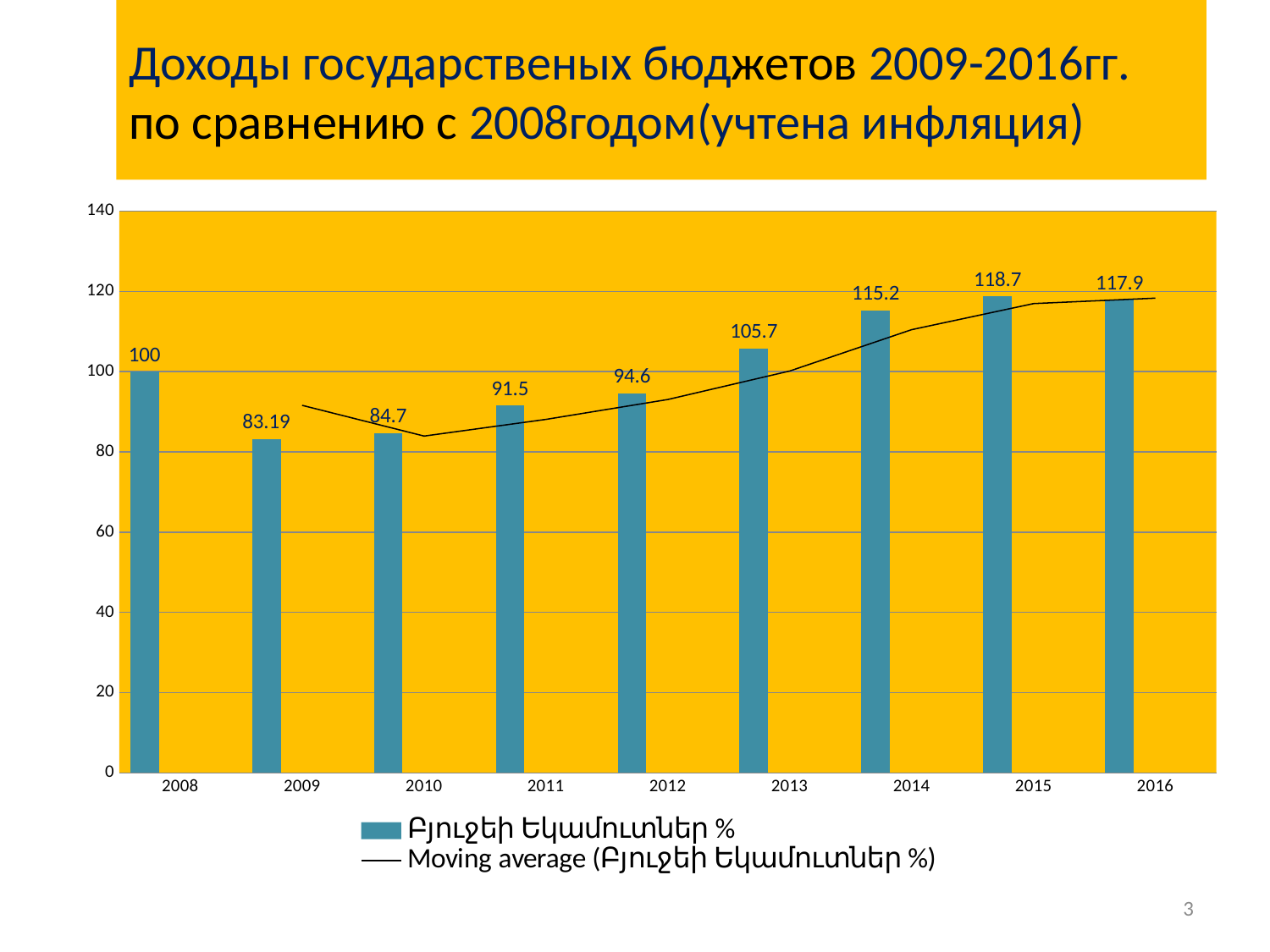
What is the difference between the values for 2015 and 2014? 3.5 What is the value for 2016? 117.9 Which year has the highest value? 2015 What is the value for 2013? 105.7 Do the bar values rise or fall from 2010 to 2015? Rise Which year has the lowest value? 2009 Which is larger, the value for 2011 or the value for 2012? 2012 What kind of chart is this? Bar chart with a moving average line Is the value for 2014 greater or less than 100? greater How many years are shown on the x axis? 9 How many entries does the legend list? 2 What is the value for 2009? 83.19